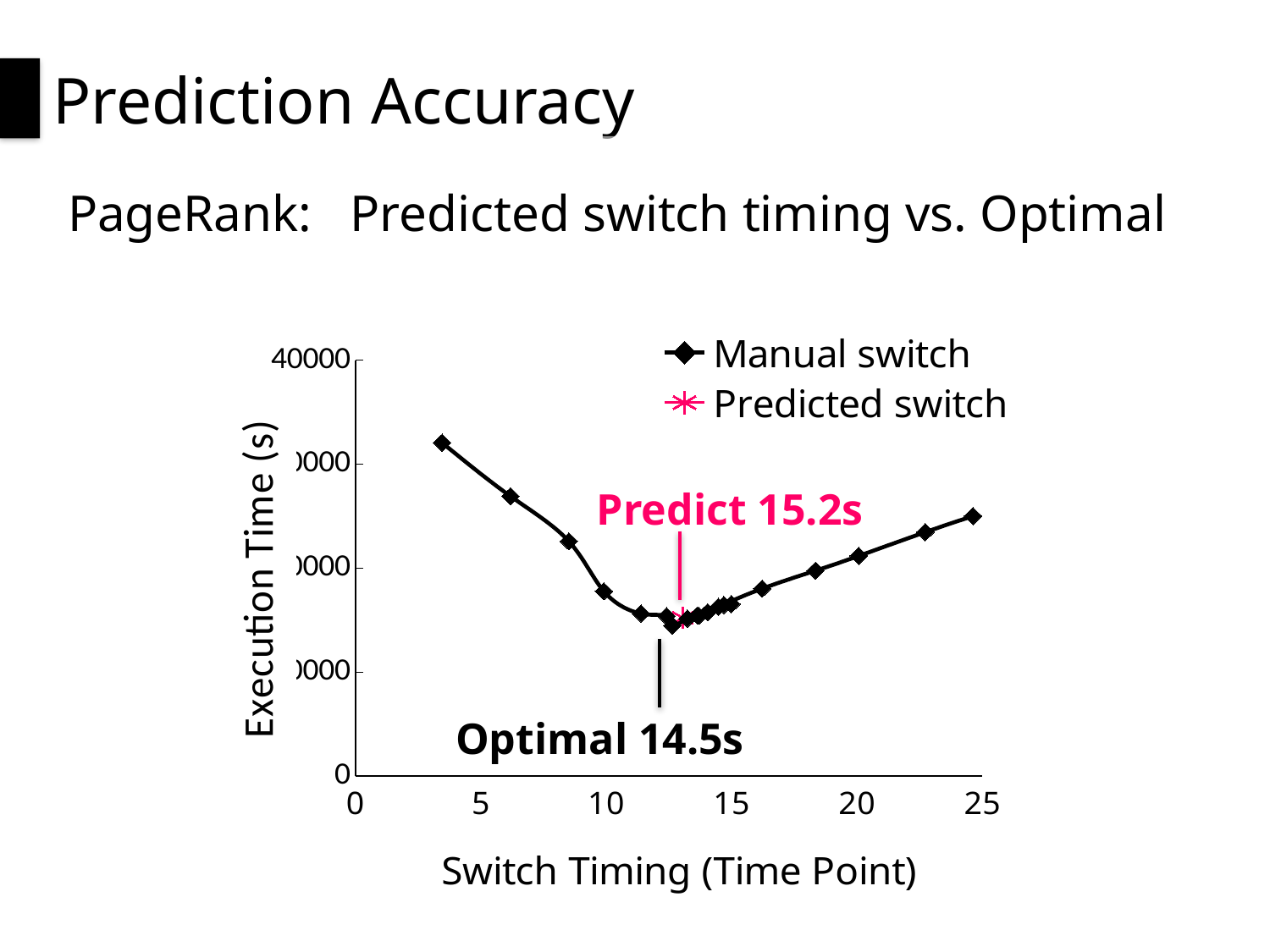
What kind of chart is shown on the slide? line chart Which has the higher execution time: the Manual switch point near switch timing 5 or the one near switch timing 10? the point near switch timing 5 What switch timing does the annotation give as the predicted value? 15.2s Does the execution time of the Manual switch series rise or fall as switch timing increases from about 13 to 25? rise What switch timing does the annotation give as the optimal value? 14.5s Is the execution time of the Predicted switch point greater or less than 20000? less How many series does the legend list? 2 Does the execution time of the Manual switch series rise or fall as switch timing increases from 0 to about 12? fall What is the difference between the predicted switch timing (15.2s) and the optimal switch timing (14.5s)? 0.7s Is the execution time of the leftmost Manual switch point (near switch timing 3.5) greater or less than 20000? greater What are the two series named in the legend? Manual switch and Predicted switch What is the label of the y axis? Execution Time (s)